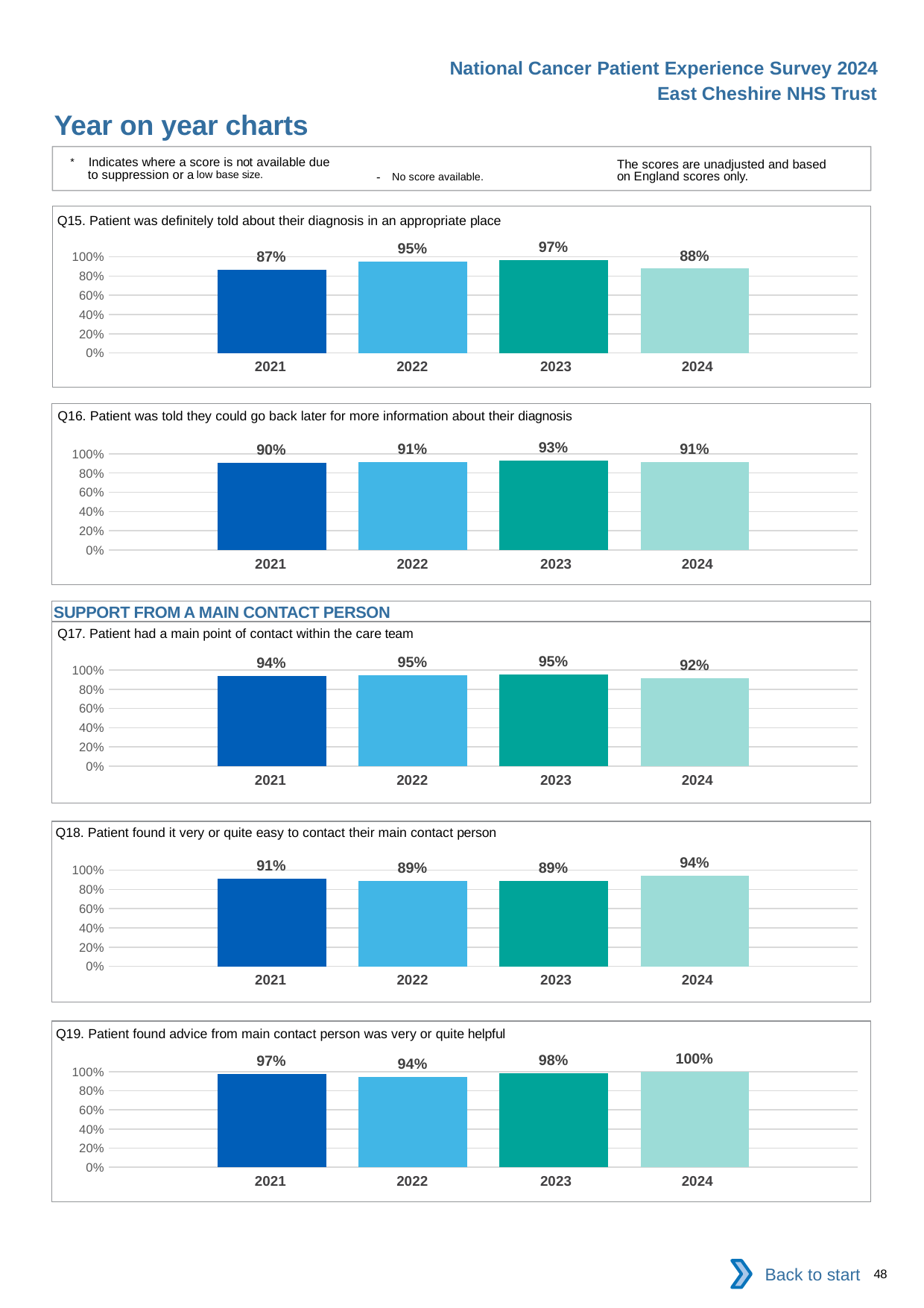
In the Q16 chart, what is the difference between the 2023 and 2021 values? 3% How many years are shown in the Q15 chart? 4 In the Q18 chart, what is the difference between the 2024 and 2023 values? 5% In the Q18 chart, what is the value for 2022? 89% What type of chart is the Q19 chart? Bar chart In the Q17 chart, what is the value for 2024? 92% In the Q19 chart, which year has the highest value? 2024 In the Q16 chart, which year has the highest value? 2023 In the Q17 chart, which is larger, the value for 2021 or the value for 2024? 2021 In the Q15 chart, which year has the lowest value? 2021 In the Q15 chart, what is the value for 2023? 97% In the Q19 chart, what is the value for 2022? 94%